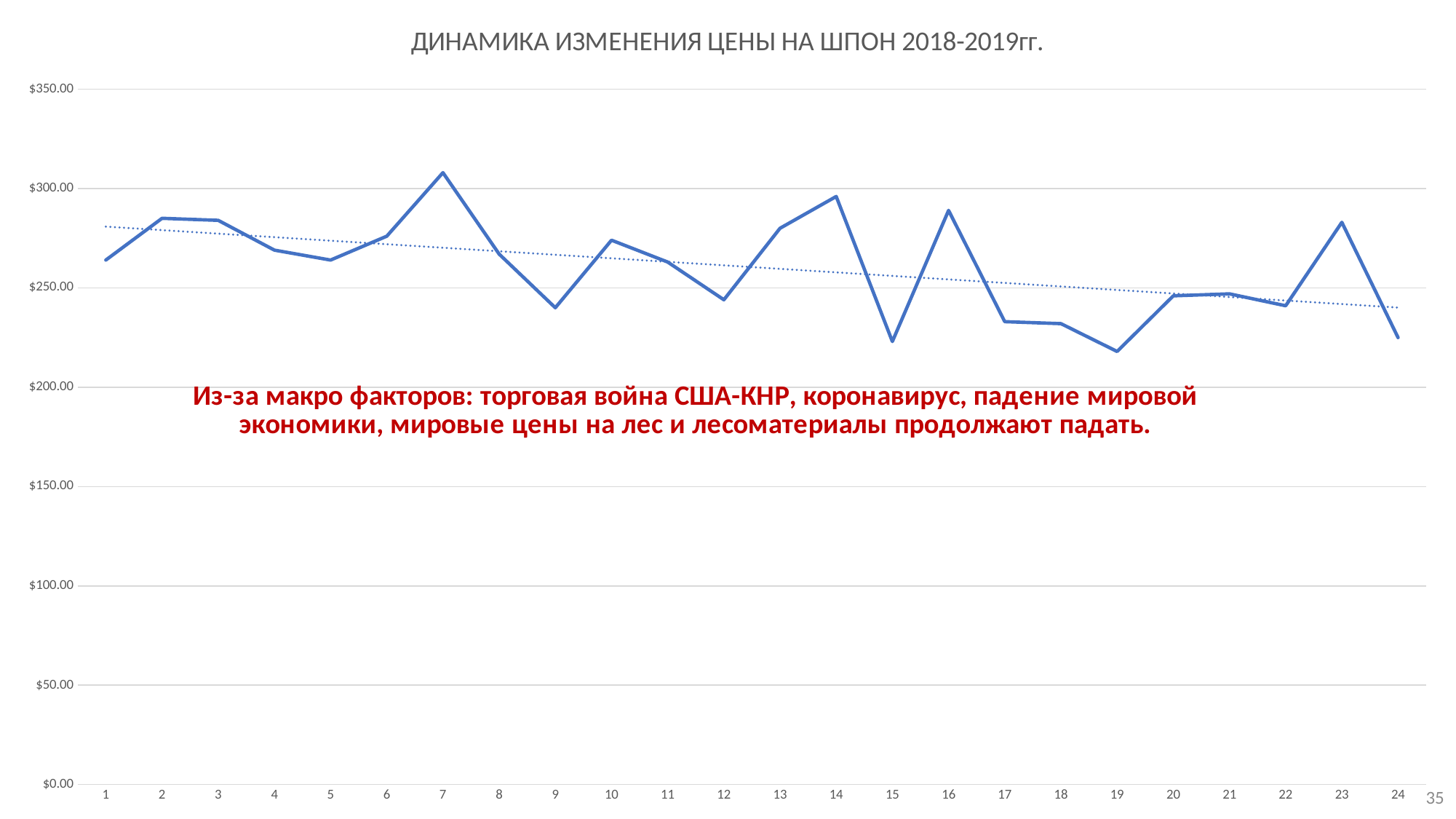
At which x-axis point is the price highest? 7 Is the value at point 2 greater or less than $250.00? greater Is the value at point 7 greater or less than $300.00? greater Is the value at point 15 greater or less than $250.00? less Which has the higher value, point 16 or point 17? point 16 What is the title of the chart? ДИНАМИКА ИЗМЕНЕНИЯ ЦЕНЫ НА ШПОН 2018-2019гг. At which x-axis point is the price lowest? 19 Do the values generally rise or fall from point 1 to point 24? fall What kind of chart is shown on the slide? line chart How many points are plotted along the x axis of the chart? 24 Which has the higher value, point 7 or point 24? point 7